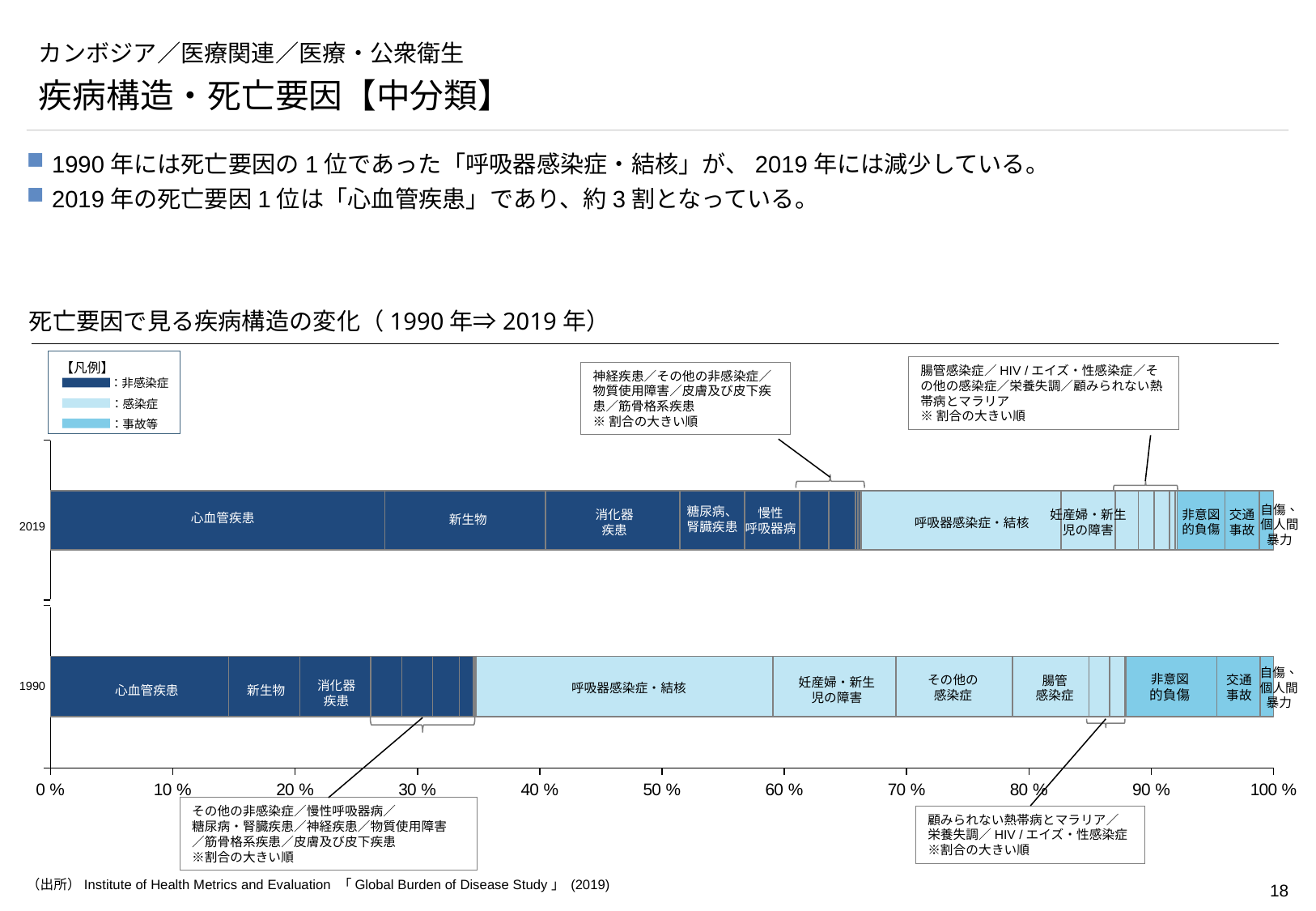
Which cause of death has the largest share in the 1990 bar? 呼吸器感染症・結核 Is the share of 呼吸器感染症・結核 in 1990 greater or less than 20%? greater Is the share of 呼吸器感染症・結核 larger in 1990 or in 2019? 1990 Is the share of 心血管疾患 in 2019 greater or less than 20%? greater How many years (bars) are plotted in the chart? 2 What kind of chart is shown on the slide? Stacked bar chart How many entries does the legend (凡例) list? 3 Which legend category is shown in dark blue? 非感染症 Is the share of 心血管疾患 in 1990 greater or less than 20%? less Is the share of 心血管疾患 larger in 1990 or in 2019? 2019 Which cause of death has the largest share in the 2019 bar? 心血管疾患 Which two years are compared in the chart? 1990 and 2019